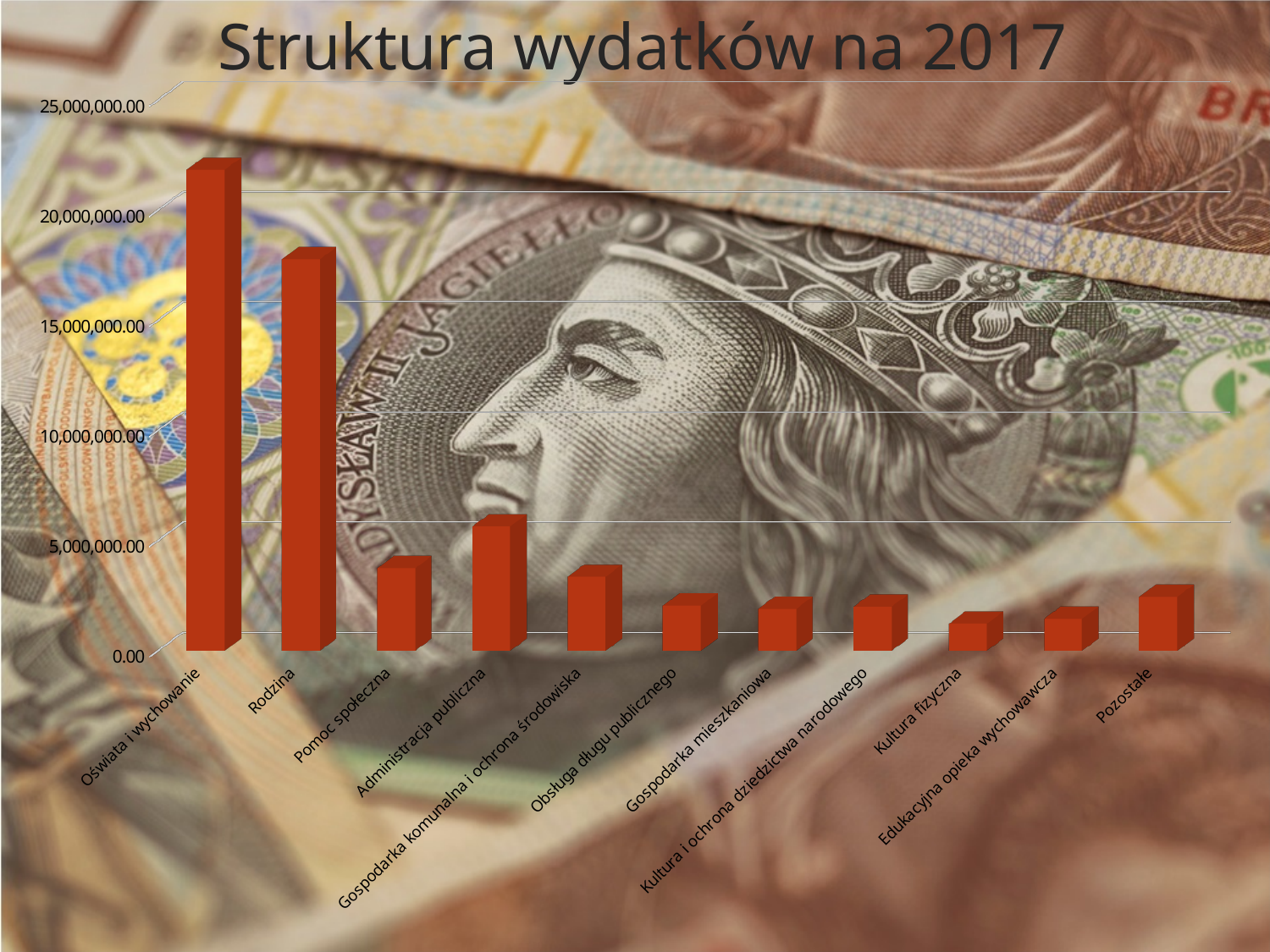
Which category has the highest value in the chart? Oświata i wychowanie Is the value for Oświata i wychowanie greater or less than 20,000,000.00? greater Is the value for Rodzina greater or less than 15,000,000.00? greater What kind of chart is shown on the slide? bar chart Which is larger, the value for Pozostałe or the value for Kultura fizyczna? Pozostałe Which is larger, the value for Rodzina or the value for Pomoc społeczna? Rodzina Is the value for Pomoc społeczna greater or less than 5,000,000.00? less What is the title of the chart? Struktura wydatków na 2017 Which category has the lowest value in the chart? Kultura fizyczna Which is larger, the value for Administracja publiczna or the value for Gospodarka komunalna i ochrona środowiska? Administracja publiczna How many categories are shown on the x axis of the chart? 11